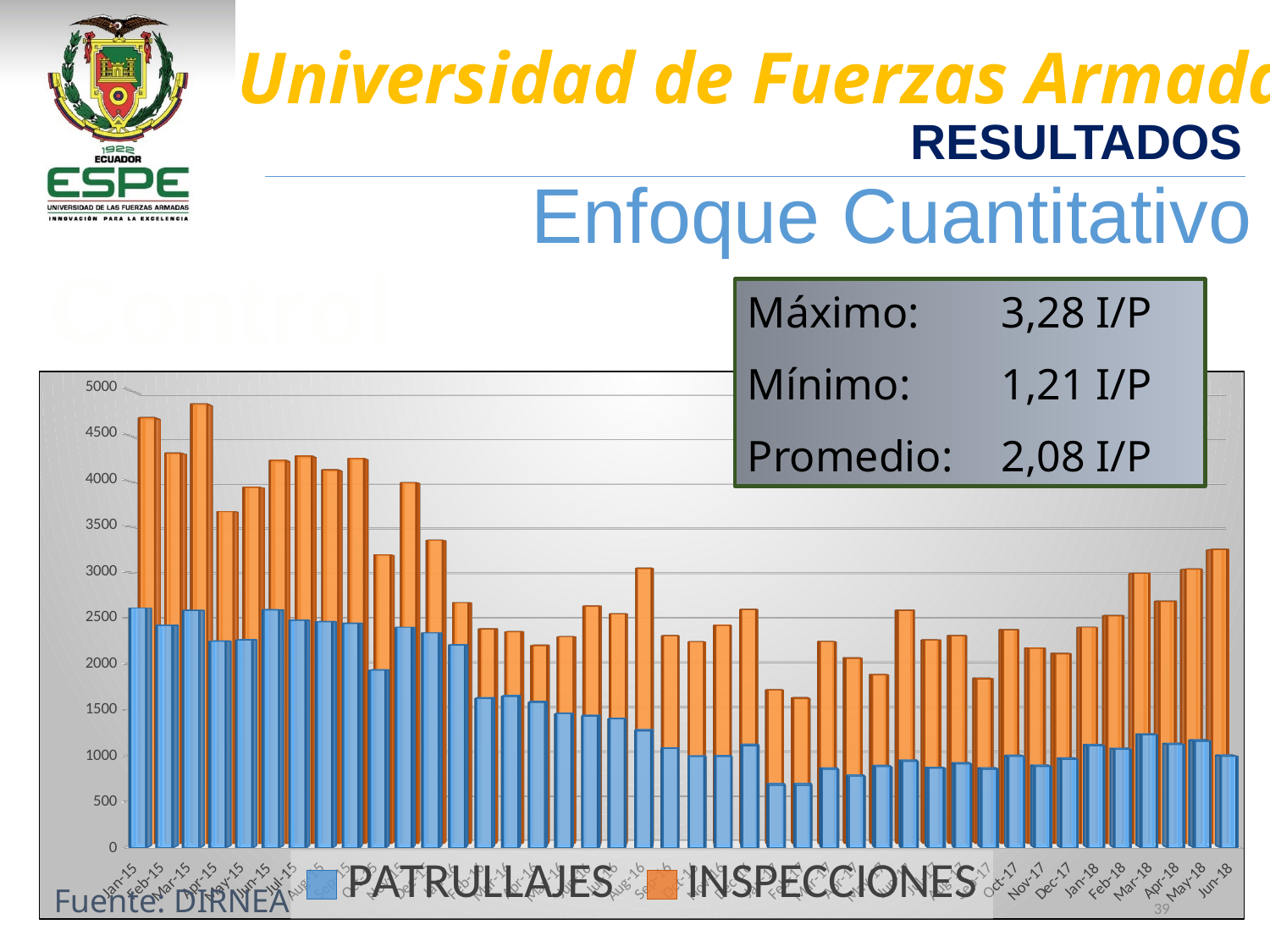
Is the INSPECCIONES value for Apr-15 greater or less than 4500? less Is the PATRULLAJES value for Jan-15 greater or less than 2000? greater How many series does the chart's legend list? 2 What kind of chart is shown on the slide? bar chart Is the PATRULLAJES value for Nov-17 greater or less than 1000? less For Jan-15, which series has the larger value, PATRULLAJES or INSPECCIONES? INSPECCIONES Overall, do the PATRULLAJES values rise or fall from Jan-15 to Jun-18? fall Which colour represents INSPECCIONES in the chart? orange For Jun-18, which series has the larger value, PATRULLAJES or INSPECCIONES? INSPECCIONES What are the two series named in the chart's legend? PATRULLAJES and INSPECCIONES